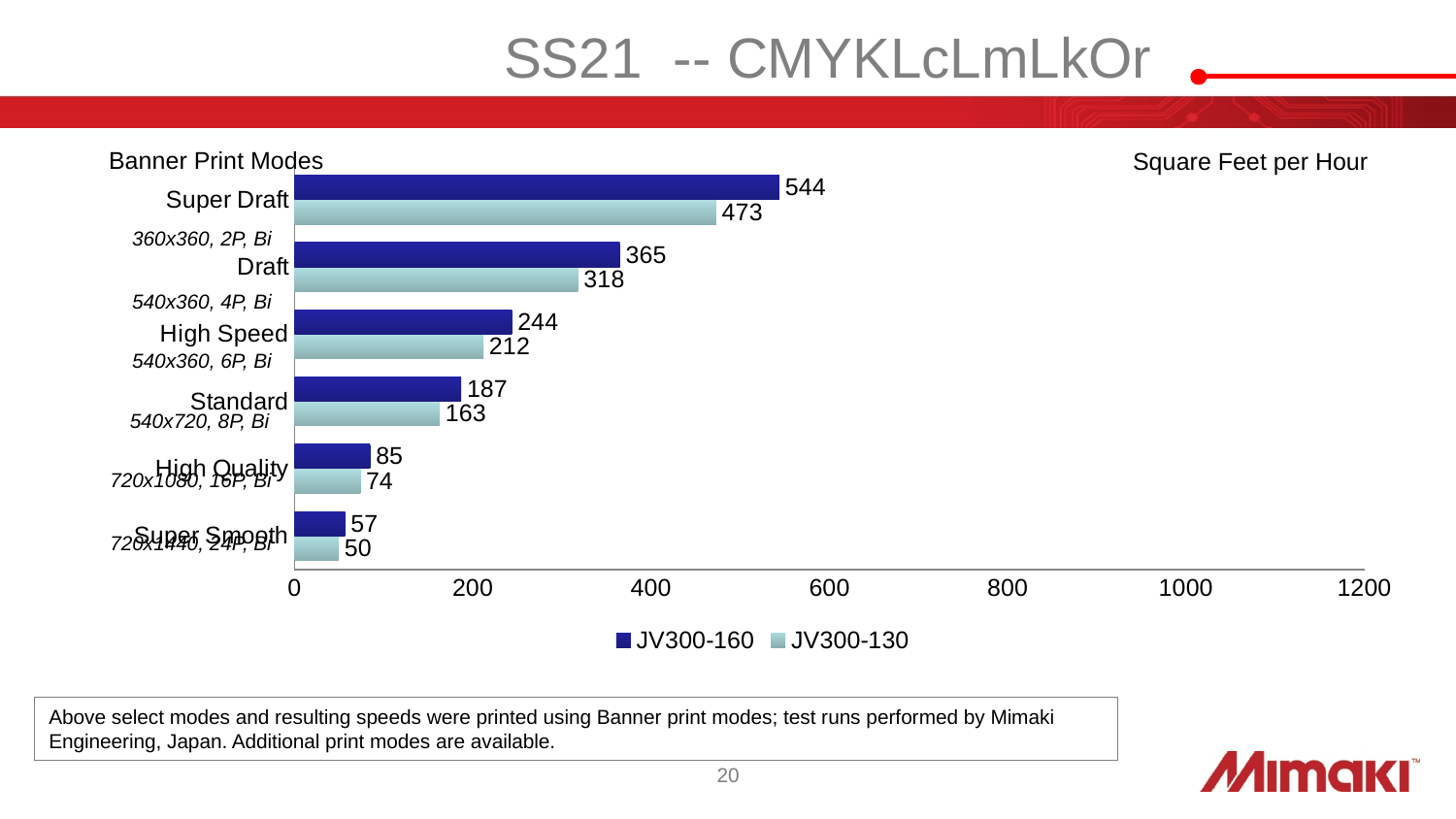
Which print mode has the lowest JV300-130 value? Super Smooth How many print modes are shown on the chart? 6 Which is larger: the JV300-160 value for High Quality or the JV300-130 value for Standard? JV300-130 value for Standard What is the JV300-130 value for High Speed? 212 What is the JV300-160 value for Standard? 187 How many series does the legend list? 2 What is the JV300-130 value for Draft? 318 What is the JV300-160 value for Super Draft? 544 What kind of chart is shown on the slide? bar chart What is the difference between the JV300-160 and JV300-130 values for Super Draft? 71 Which print mode has the highest JV300-160 value? Super Draft What is the maximum value shown on the horizontal axis? 1200